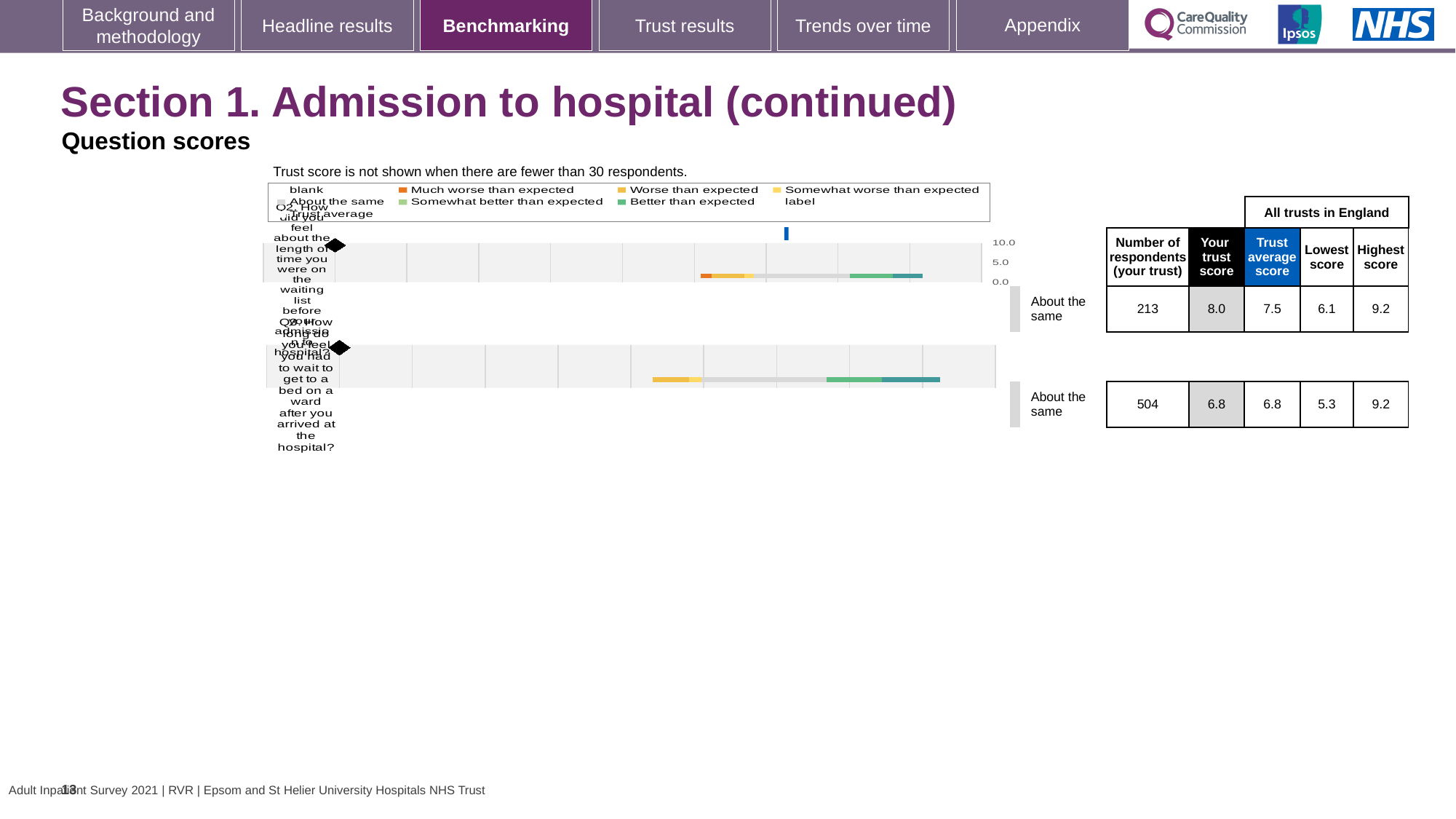
For the top chart (Q2, length of time on the waiting list), what is the trust score shown in the table? 8.0 What kind of chart is used to show the question scores on this slide? bar chart For the top chart (Q2), how many respondents did the trust have? 213 Which question has the higher trust score, Q2 (top chart) or Q3 (bottom chart)? Q2 What is the highest tick value shown on the score axis of the top chart? 10.0 Which legend entry is shown in orange in the chart legend? Much worse than expected How many benchmarking bar charts are shown on the slide? 2 For the bottom chart (Q3, wait to get to a bed on a ward), what is the trust score shown in the table? 6.8 For the bottom chart (Q3), what is the lowest score among all trusts in England? 5.3 What is the difference between the trust score and the trust average score for Q2 (top chart)? 0.5 For the top chart (Q2), what is the trust average score for all trusts in England? 7.5 What benchmark category is the trust placed in for Q3 (bottom chart)? About the same